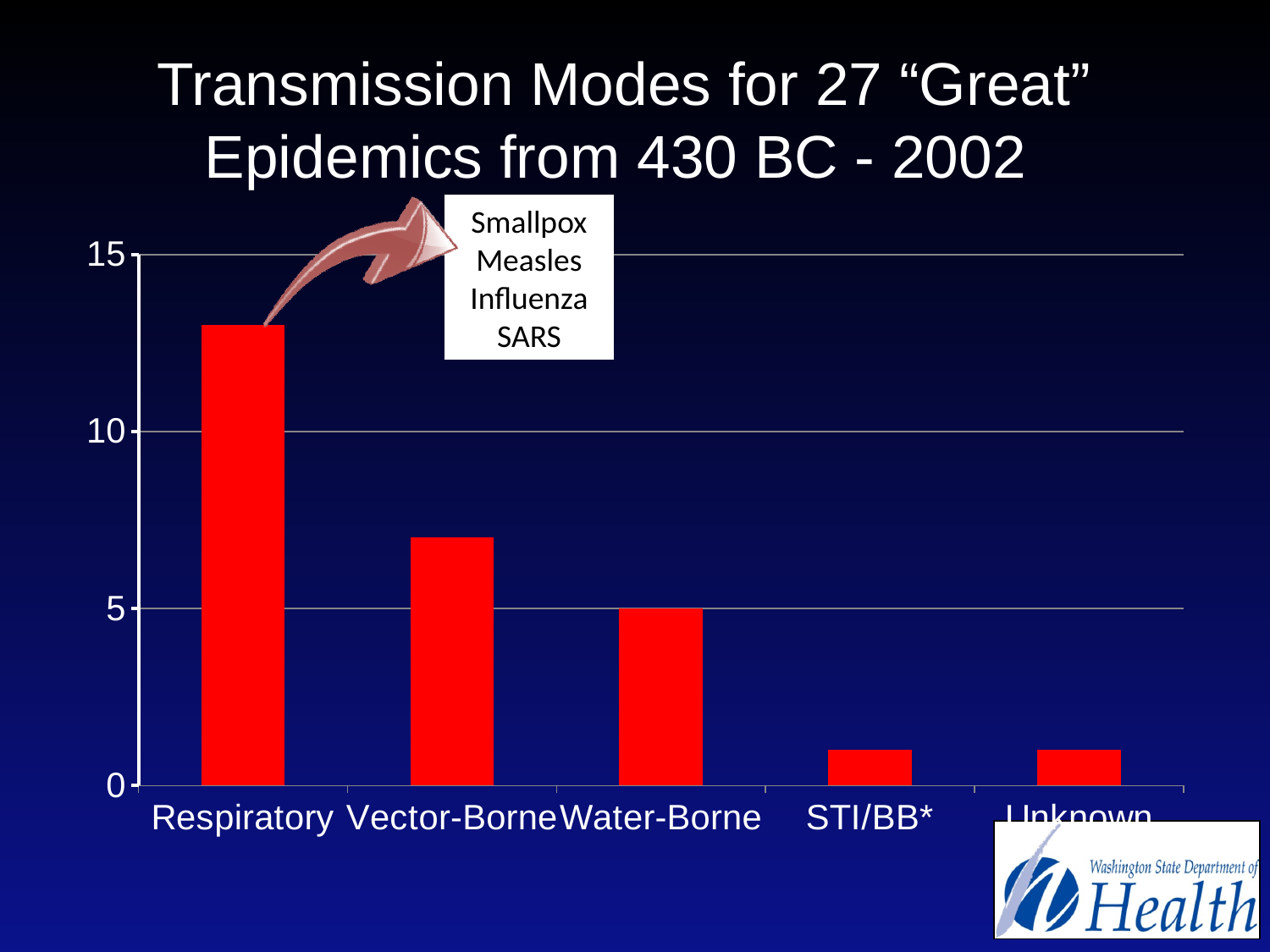
Is the value for STI/BB* greater or less than 5? less Which is larger, the value for Vector-Borne or the value for Water-Borne? Vector-Borne How many transmission mode categories are shown on the x axis? 5 Which four diseases are listed in the callout box pointing to the Respiratory bar? Smallpox, Measles, Influenza, SARS Which is larger, the value for Respiratory or the value for Vector-Borne? Respiratory What is the title of the chart? Transmission Modes for 27 "Great" Epidemics from 430 BC - 2002 What kind of chart is shown on the slide? bar chart Do the bar values generally rise or fall from left to right across the x axis? fall Which transmission mode has the highest number of epidemics? Respiratory Is the value for Vector-Borne greater or less than 5? greater Is the value for Respiratory greater or less than 10? greater What is the value for Water-Borne? 5